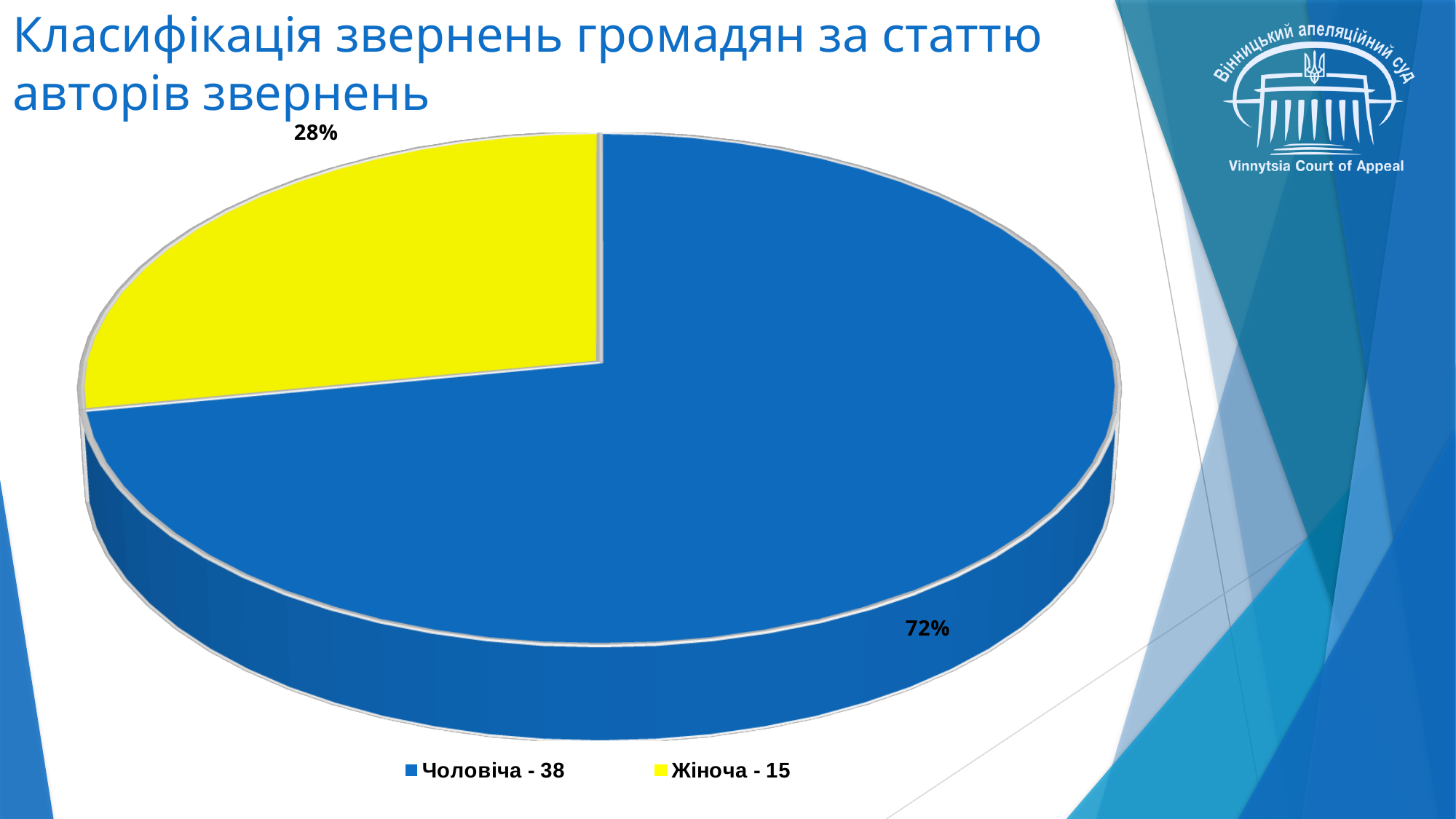
What percentage share does the Чоловіча slice have? 72% What is the difference between the counts for Чоловіча and Жіноча shown in the legend? 23 How many entries does the legend list? 2 Which category has the largest slice of the pie? Чоловіча Which category has the smallest slice of the pie? Жіноча What count is shown in the legend for Чоловіча? 38 What percentage share does the Жіноча slice have? 28% What count is shown in the legend for Жіноча? 15 How many slices does the pie chart have? 2 What kind of chart is shown on the slide? pie chart What colour is the Жіноча slice? yellow Which is larger, the Чоловіча slice or the Жіноча slice? Чоловіча